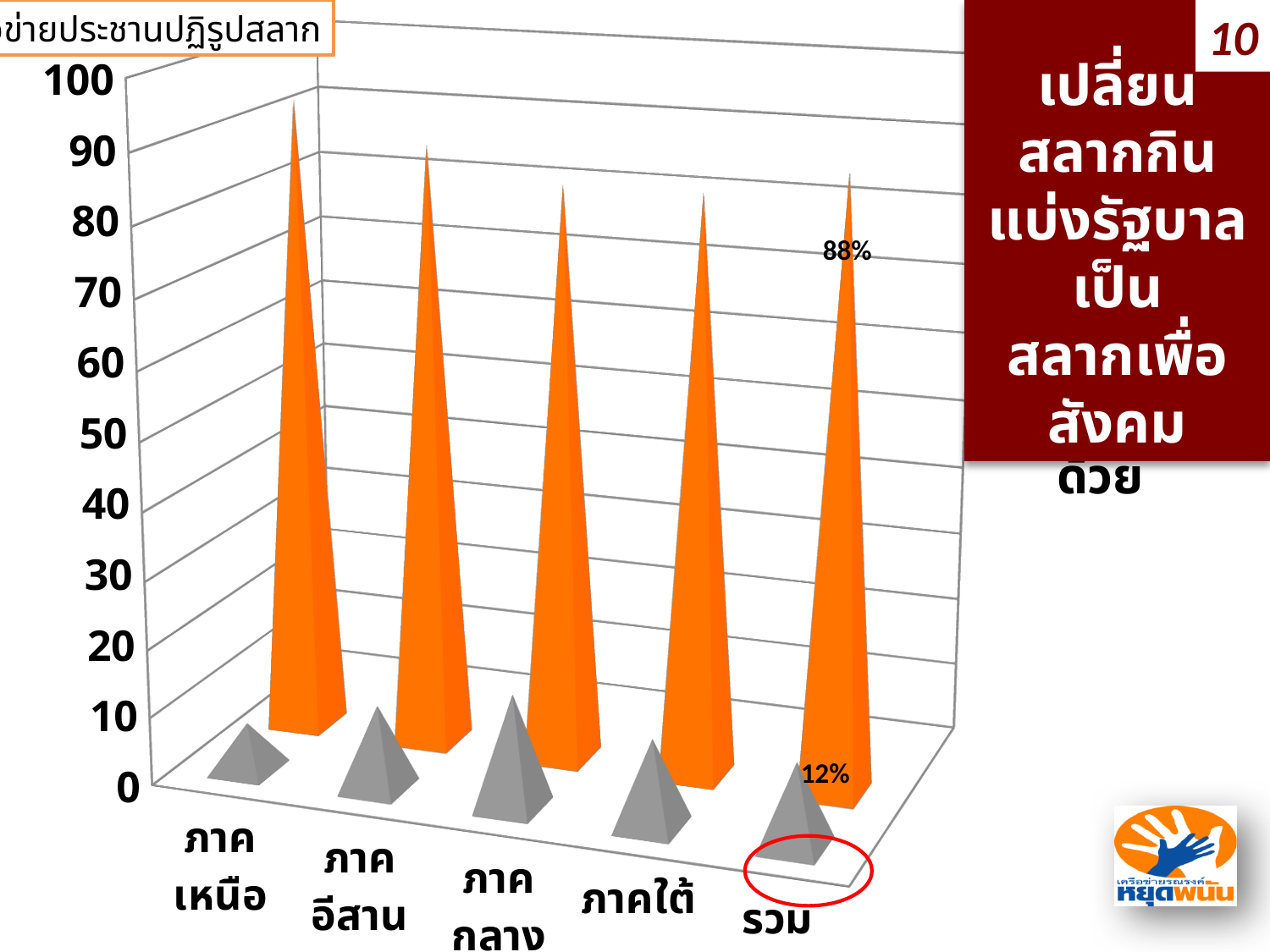
For รวม, which is larger: the orange value or the gray value? the orange value What is the difference between the orange and gray values for รวม? 76% Is the orange value for ภาคเหนือ greater or less than 50? greater Is the orange value for ภาคใต้ greater or less than 40? greater What is the value of the orange series for รวม? 88% What is the value of the gray series for รวม? 12% Is the gray value for ภาคกลาง greater or less than 30? less How many categories are shown on the x axis? 5 For ภาคเหนือ, which is larger: the orange value or the gray value? the orange value What kind of chart is shown on the slide? bar chart What two colours are used for the bars in the chart? orange and gray What is the highest value shown on the vertical axis? 100